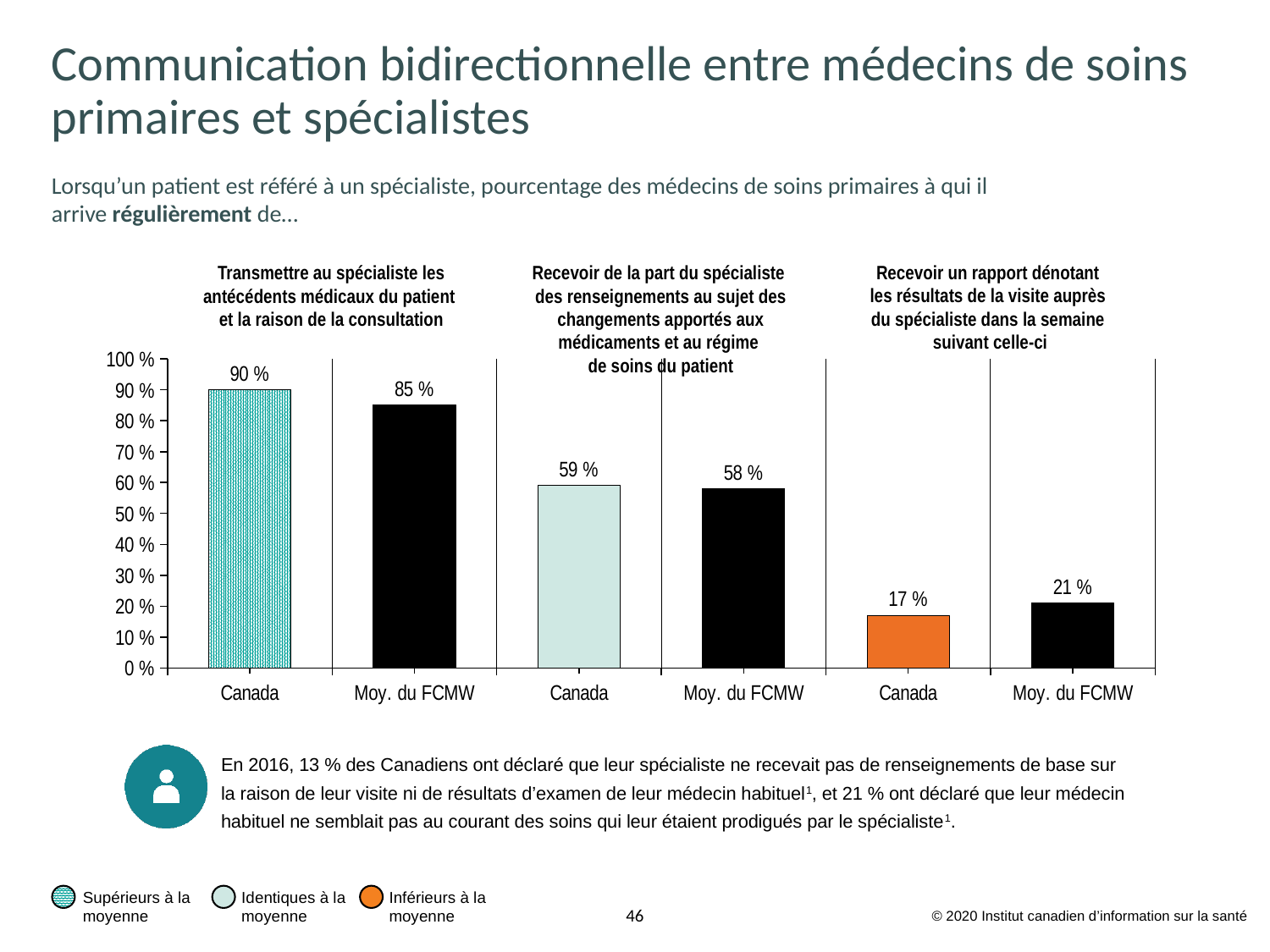
What is the value for Moy. du FCMW under "Recevoir un rapport dénotant les résultats de la visite auprès du spécialiste dans la semaine suivant celle-ci"? 21 % What is the value for Canada under "Transmettre au spécialiste les antécédents médicaux du patient et la raison de la consultation"? 90 % Under "Recevoir un rapport dénotant les résultats de la visite auprès du spécialiste dans la semaine suivant celle-ci", which is larger: Canada or Moy. du FCMW? Moy. du FCMW What is the value for Moy. du FCMW under "Transmettre au spécialiste les antécédents médicaux du patient et la raison de la consultation"? 85 % What type of chart is shown on the slide? bar chart Which bar has the lowest value on the chart? Canada, Recevoir un rapport dénotant les résultats de la visite auprès du spécialiste dans la semaine suivant celle-ci (17 %) What colour is the Canada bar under "Recevoir un rapport dénotant les résultats de la visite auprès du spécialiste dans la semaine suivant celle-ci"? orange Which bar has the highest value on the chart? Canada, Transmettre au spécialiste les antécédents médicaux du patient et la raison de la consultation (90 %) What is the value for Canada under "Recevoir un rapport dénotant les résultats de la visite auprès du spécialiste dans la semaine suivant celle-ci"? 17 % What is the difference between Canada and Moy. du FCMW under "Transmettre au spécialiste les antécédents médicaux du patient et la raison de la consultation"? 5 % How many bars are plotted on the chart? 6 What is the value for Canada under "Recevoir de la part du spécialiste des renseignements au sujet des changements apportés aux médicaments et au régime de soins du patient"? 59 %